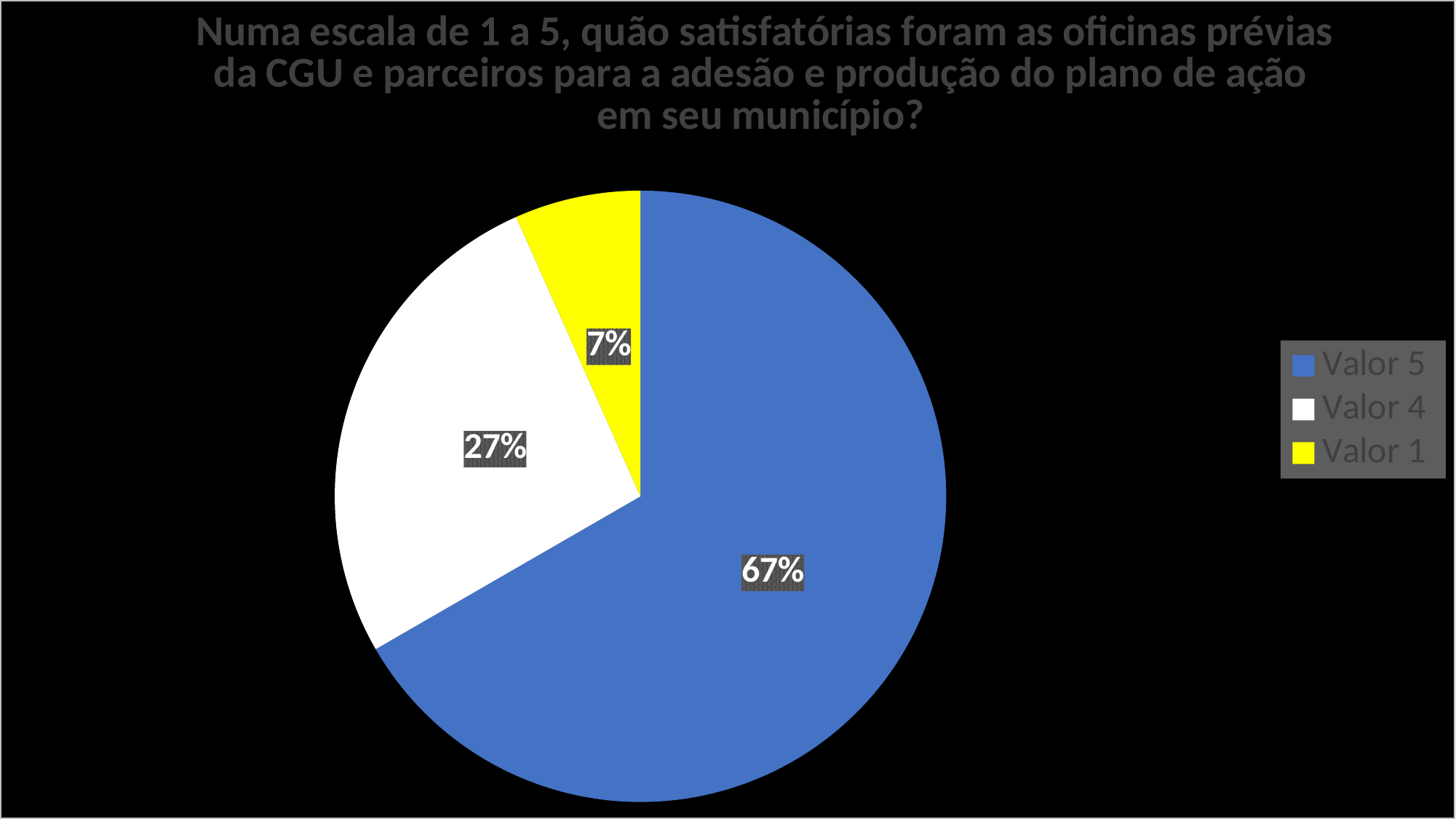
What share of the pie does Valor 5 represent? 67% What is the difference in percentage points between Valor 4 and Valor 1? 20 What share of the pie does Valor 4 represent? 27% What kind of chart is shown on the slide? pie chart Which is larger, the share for Valor 4 or the share for Valor 1? Valor 4 How many slices does the pie chart have? 3 What share of the pie does Valor 1 represent? 7% What is the difference in percentage points between Valor 5 and Valor 4? 40 What colour is the slice for Valor 1? yellow How many entries does the legend list? 3 Which category has the largest slice of the pie? Valor 5 Which category has the smallest slice of the pie? Valor 1